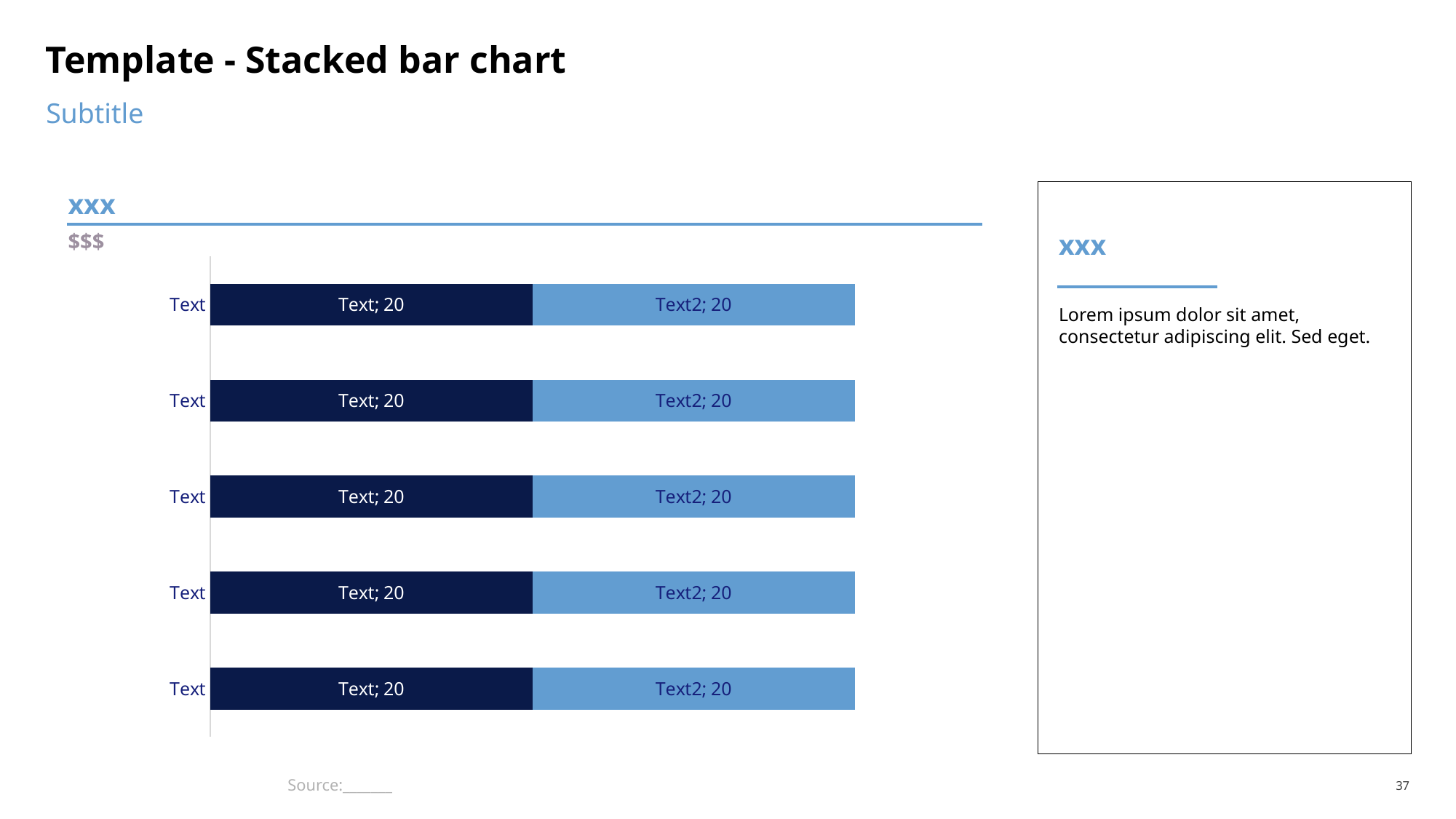
What is the total of the top stacked bar? 40 What is the total of the bottom stacked bar? 40 What is the value of the 'Text2' segment in the bottom bar? 20 What is the title shown above the chart? XXX How many series are stacked in each bar of the chart? 2 What unit label is shown at the top left of the chart area? $$$ What is the category label of the bottom bar? Text How many bars (categories) does the chart show? 5 Do the bar totals increase, decrease, or stay the same from the top bar to the bottom bar? Stay the same Is the 'Text' segment in the top bar larger than, smaller than, or equal to the 'Text2' segment in the same bar? Equal What is the value of the 'Text' segment in the top bar? 20 What kind of chart is shown on the slide? Stacked bar chart